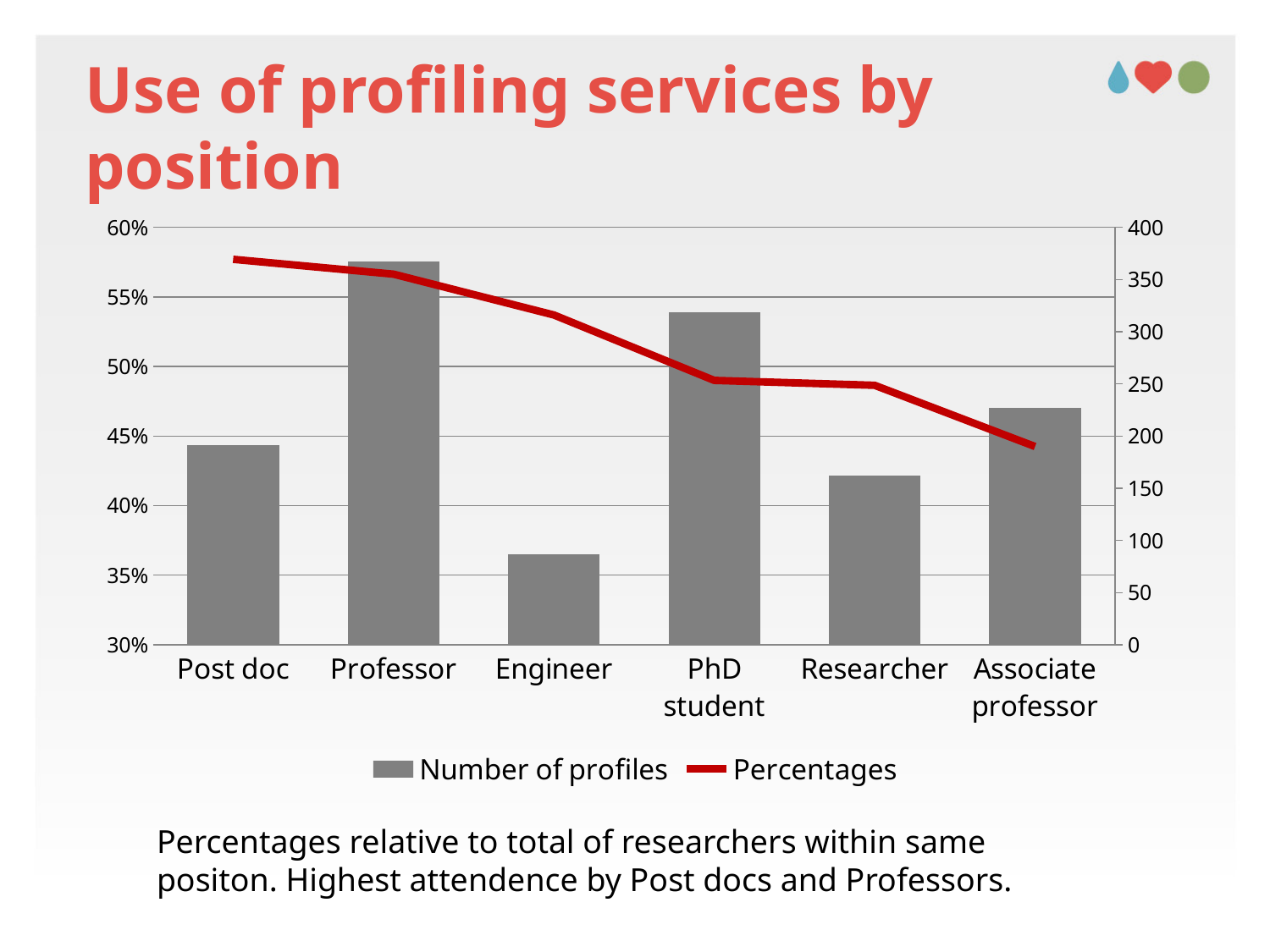
What kind of chart is shown on the slide? bar chart with a line Is the percentage for Engineer greater or less than 50%? greater Which has more profiles, Associate professor or Post doc? Associate professor Is the number of profiles for Engineer greater or less than 100? less Which position has the lowest percentage? Associate professor Is the number of profiles for Professor greater or less than 350? greater Which position has the highest number of profiles? Professor How many series does the legend list? 2 Does the Percentages line rise or fall from Post doc to Associate professor? fall Which position has the lowest number of profiles? Engineer How many positions are shown on the x axis? 6